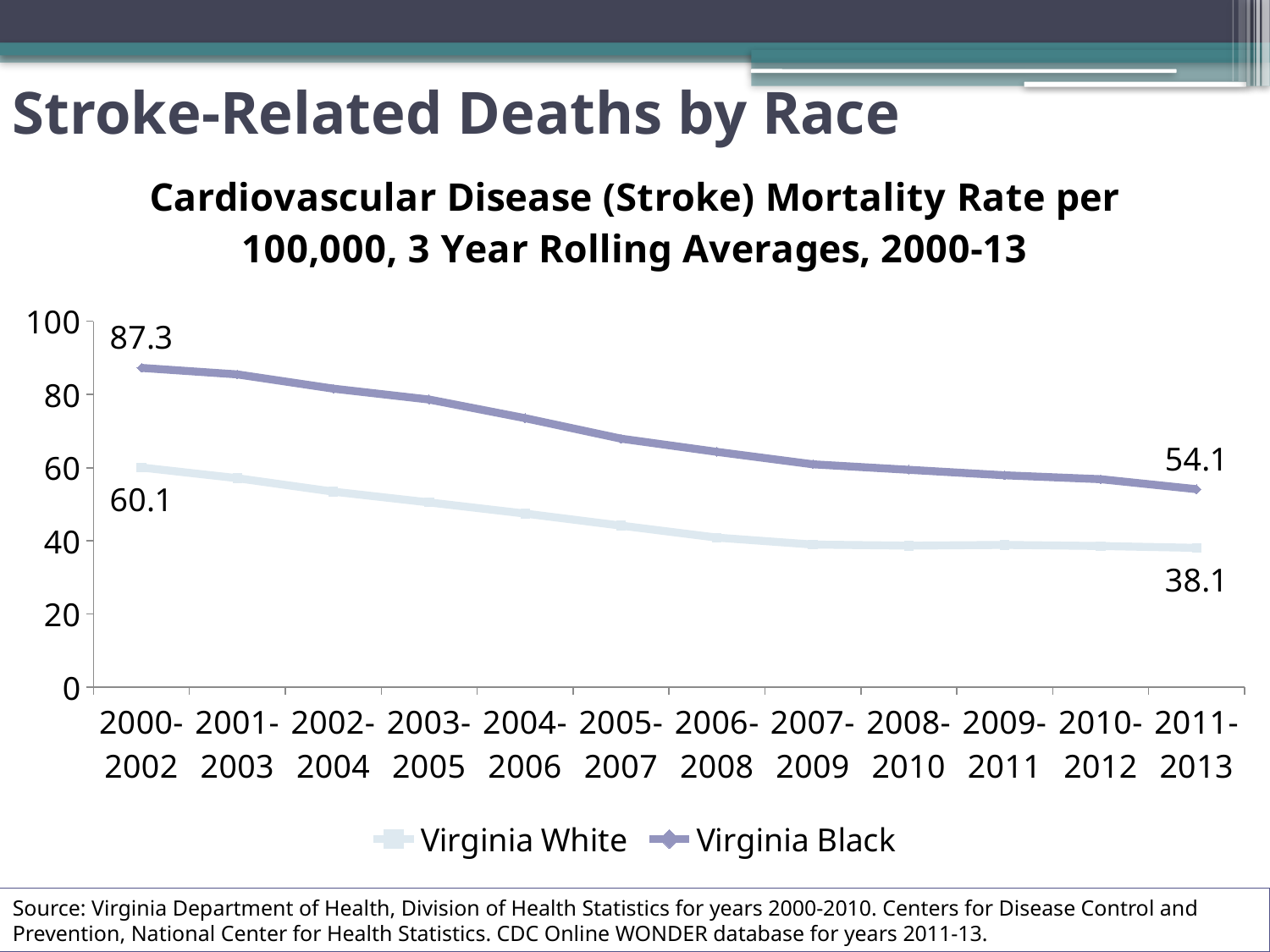
What is the Virginia White stroke mortality rate for 2011-2013? 38.1 What is the Virginia Black stroke mortality rate for 2000-2002? 87.3 By how much did the Virginia Black rate fall from 2000-2002 to 2011-2013? 33.2 Is the Virginia White rate for 2005-2007 greater or less than 60? less How many series does the legend list? 2 What is the Virginia White stroke mortality rate for 2000-2002? 60.1 Which series has the higher rate in 2000-2002, Virginia White or Virginia Black? Virginia Black Is the Virginia Black rate for 2004-2006 greater or less than 60? greater How many time periods are shown on the x axis? 12 What is the difference between the Virginia Black and Virginia White rates in 2011-2013? 16.0 What kind of chart is shown on the slide? Line chart What is the Virginia Black stroke mortality rate for 2011-2013? 54.1